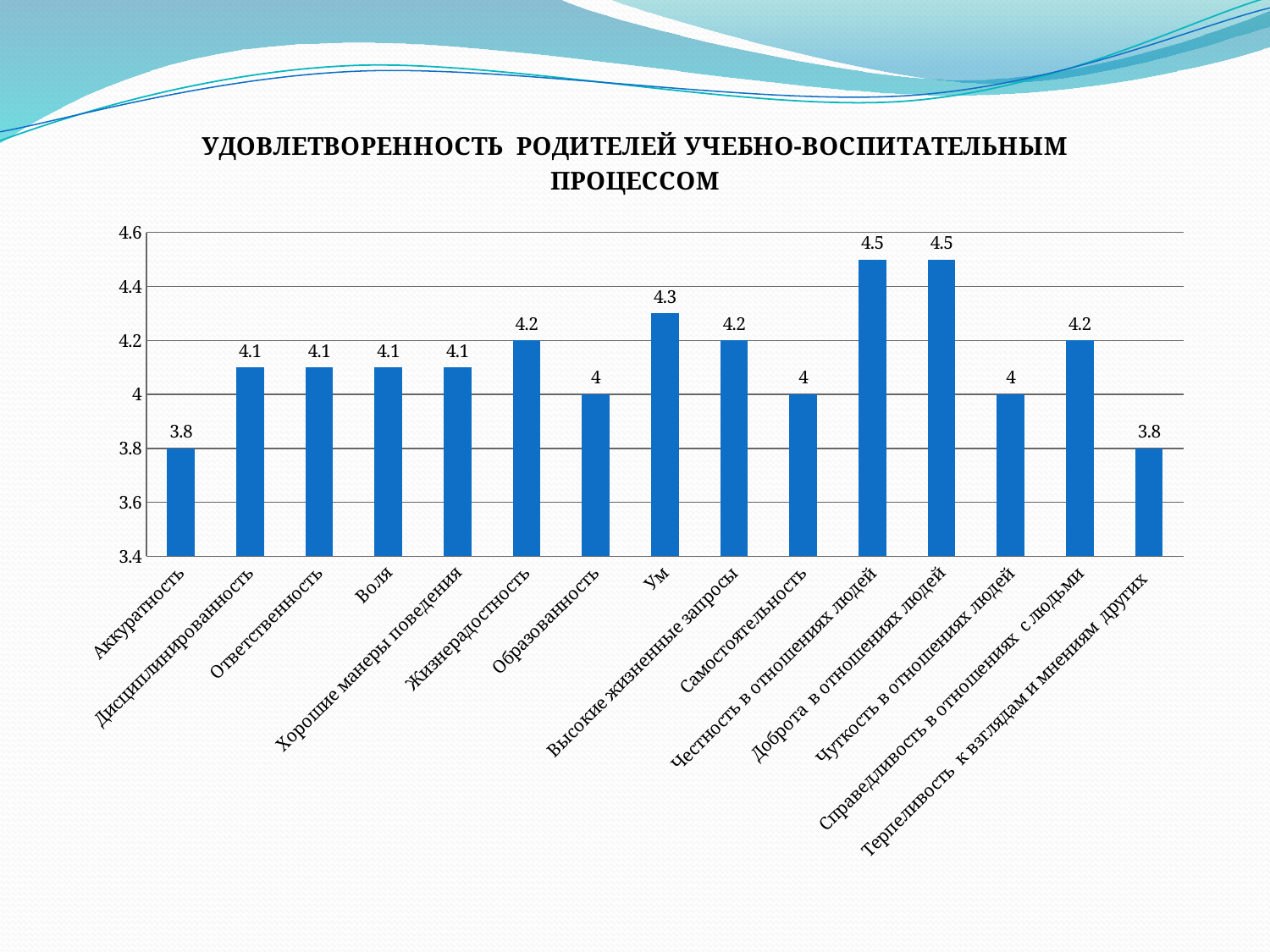
Which is larger, the value for Ум or the value for Самостоятельность? Ум How many categories are shown in the chart? 15 What is the value for Справедливость в отношениях с людьми? 4.2 What is the title of the chart? УДОВЛЕТВОРЕННОСТЬ РОДИТЕЛЕЙ УЧЕБНО-ВОСПИТАТЕЛЬНЫМ ПРОЦЕССОМ What is the lowest value shown in the chart? 3.8 What is the highest value shown in the chart? 4.5 What kind of chart is shown on the slide? bar chart What is the value for Честность в отношениях людей? 4.5 What is the value for Аккуратность? 3.8 What is the value for Образованность? 4 What is the value for Ум? 4.3 What is the difference between the values for Доброта в отношениях людей and Чуткость в отношениях людей? 0.5